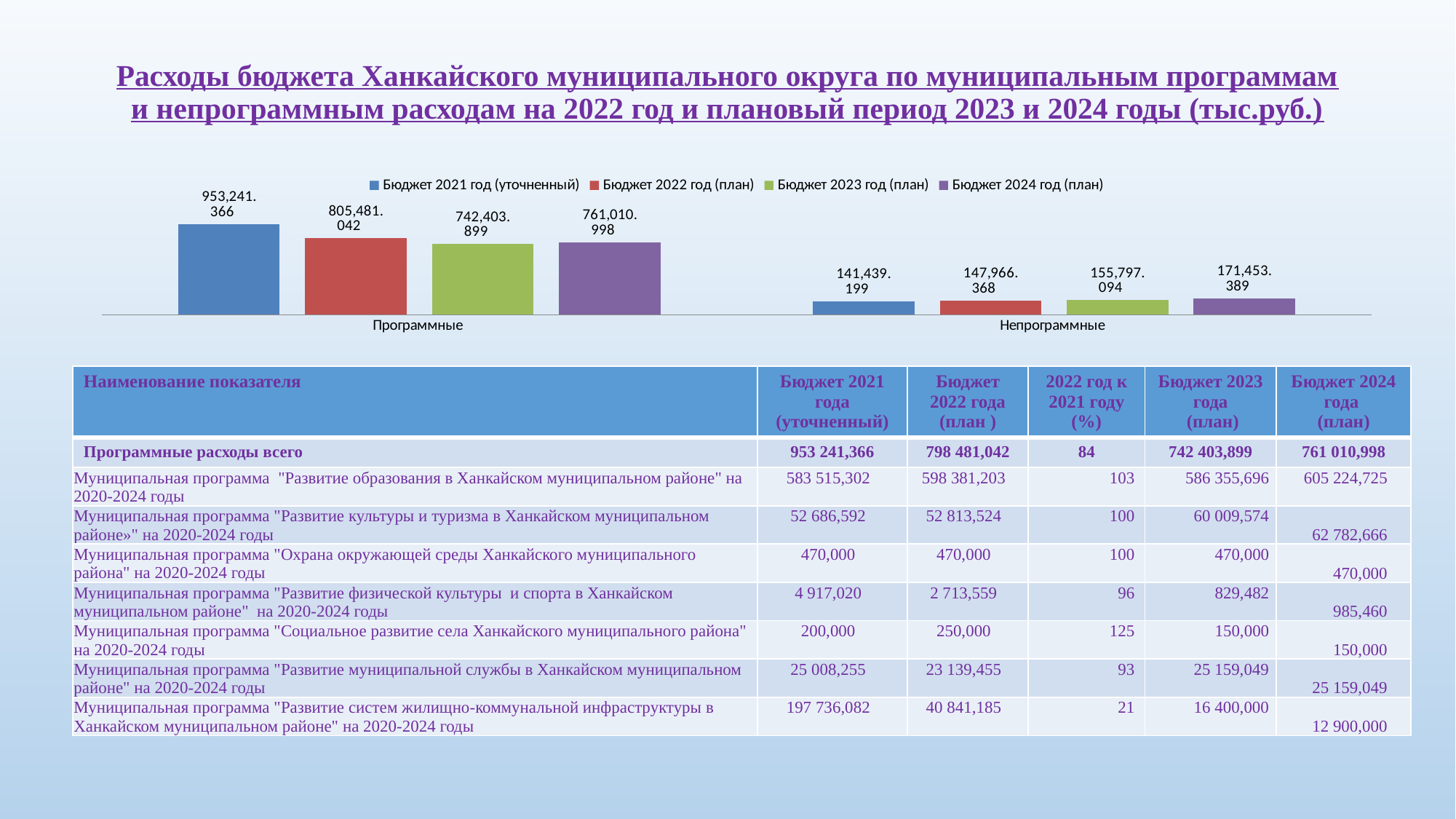
Do the 'Непрограммные' values rise or fall from the 2021 series to the 2024 series in the chart? rise What type of chart is shown on the slide? bar chart Which series has the lowest value for 'Непрограммные' in the chart? Бюджет 2021 год (уточненный) Which series has the highest value for 'Программные' in the chart? Бюджет 2021 год (уточненный) What is the value of the 'Бюджет 2024 год (план)' bar for 'Непрограммные' in the chart? 171,453.389 In the chart, is the 'Бюджет 2024 год (план)' value for 'Программные' larger or smaller than the 'Бюджет 2023 год (план)' value for 'Программные'? larger How many categories are shown on the x axis of the chart? 2 How many series does the chart legend list? 4 What is the value of the 'Бюджет 2023 год (план)' bar for 'Программные' in the chart? 742,403.899 What is the value of the 'Бюджет 2021 год (уточненный)' bar for 'Программные' in the chart? 953,241.366 Which series has the lowest value for 'Программные' in the chart? Бюджет 2023 год (план) What is the value of the 'Бюджет 2022 год (план)' bar for 'Непрограммные' in the chart? 147,966.368